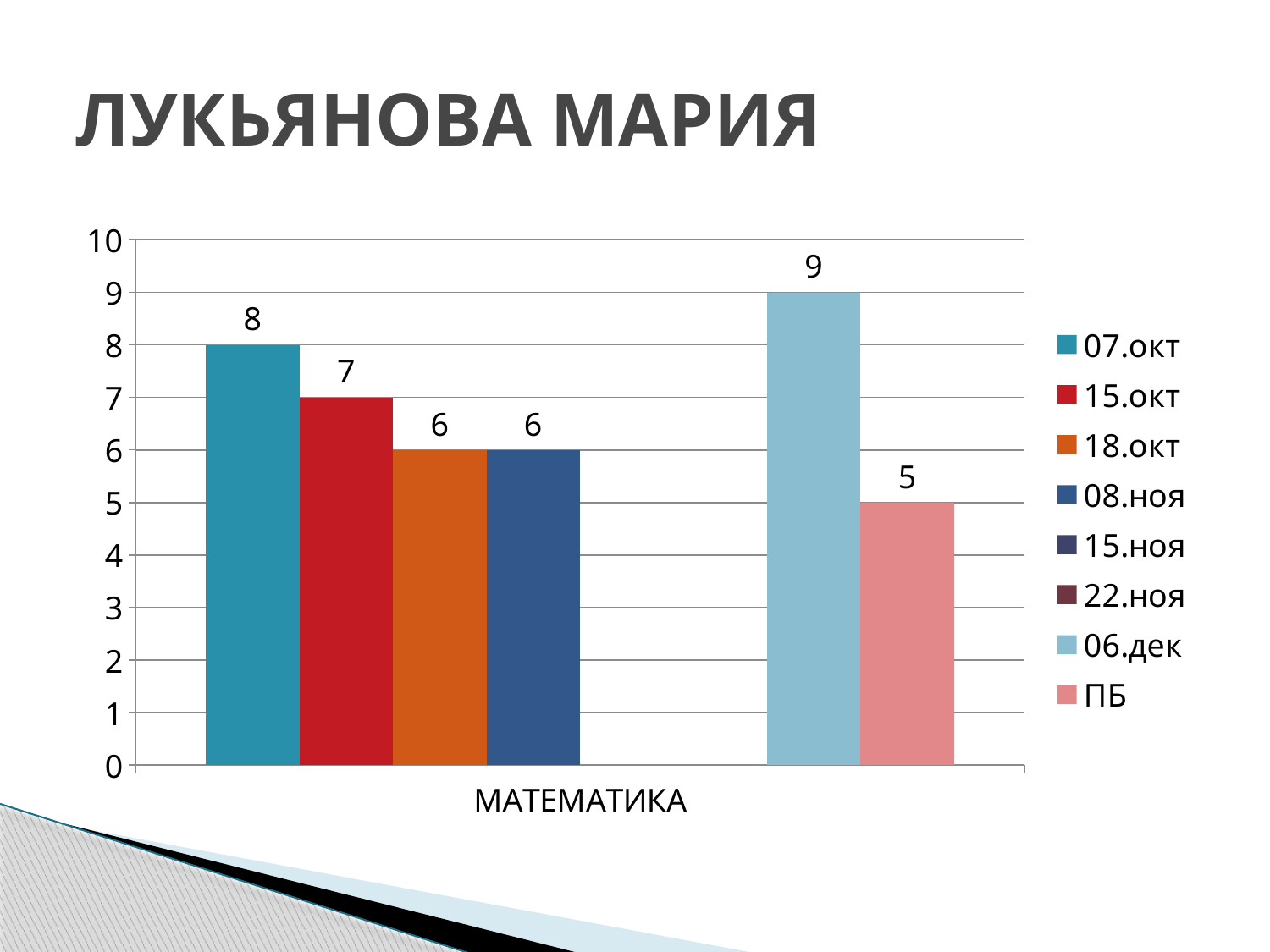
What is the value for 07.окт in МАТЕМАТИКА? 8 What is the value for 15.окт in МАТЕМАТИКА? 7 Which series has the highest value in МАТЕМАТИКА? 06.дек What is the title of the slide? ЛУКЬЯНОВА МАРИЯ How many series does the legend list? 8 What is the value for ПБ in МАТЕМАТИКА? 5 Which series with a plotted bar has the lowest value in МАТЕМАТИКА? ПБ What is the value for 06.дек in МАТЕМАТИКА? 9 How many categories are shown on the x axis? 1 Which is larger, the value for 07.окт or the value for 15.окт? 07.окт What is the difference between the values for 06.дек and ПБ? 4 What type of chart is shown on the slide? bar chart